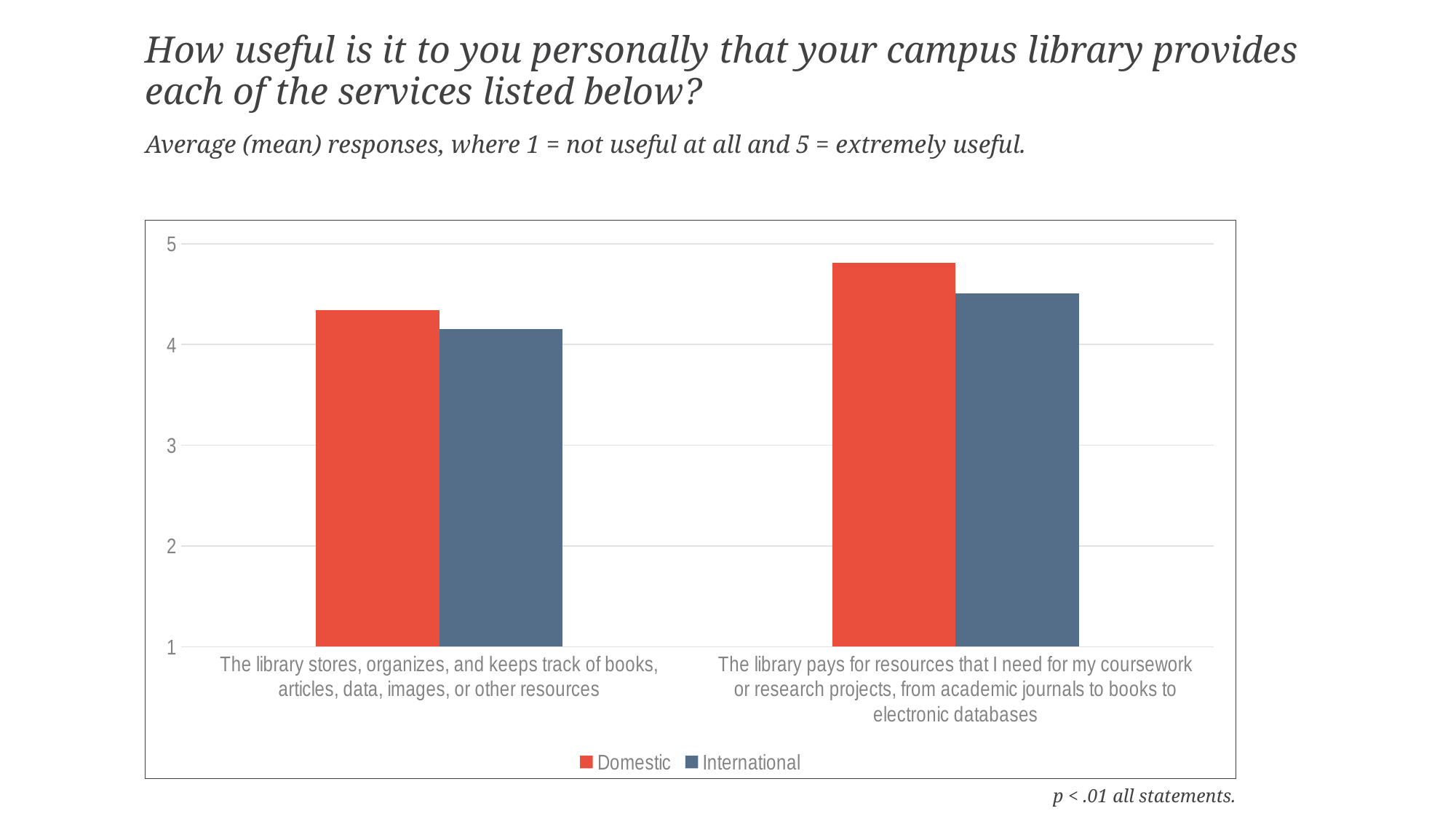
Which bar is the highest on the chart? Domestic, for "The library pays for resources that I need for my coursework or research projects" Which series has the higher value for "The library pays for resources that I need for my coursework or research projects, from academic journals to books to electronic databases": Domestic or International? Domestic How many categories (statements) are shown on the x axis? 2 What kind of chart is shown on the slide? bar chart Is the International value for "The library pays for resources that I need for my coursework or research projects" greater or less than 4? greater Which colour represents the Domestic series in the legend? red How many series does the legend list? 2 Is the Domestic value for "The library pays for resources that I need for my coursework or research projects" greater or less than 5? less According to the subtitle, what does a response of 5 mean on the scale? extremely useful Which series has the higher value for "The library stores, organizes, and keeps track of books, articles, data, images, or other resources": Domestic or International? Domestic Is the Domestic value for "The library stores, organizes, and keeps track of books, articles, data, images, or other resources" greater or less than 4? greater Which bar is the lowest on the chart? International, for "The library stores, organizes, and keeps track of books, articles, data, images, or other resources"